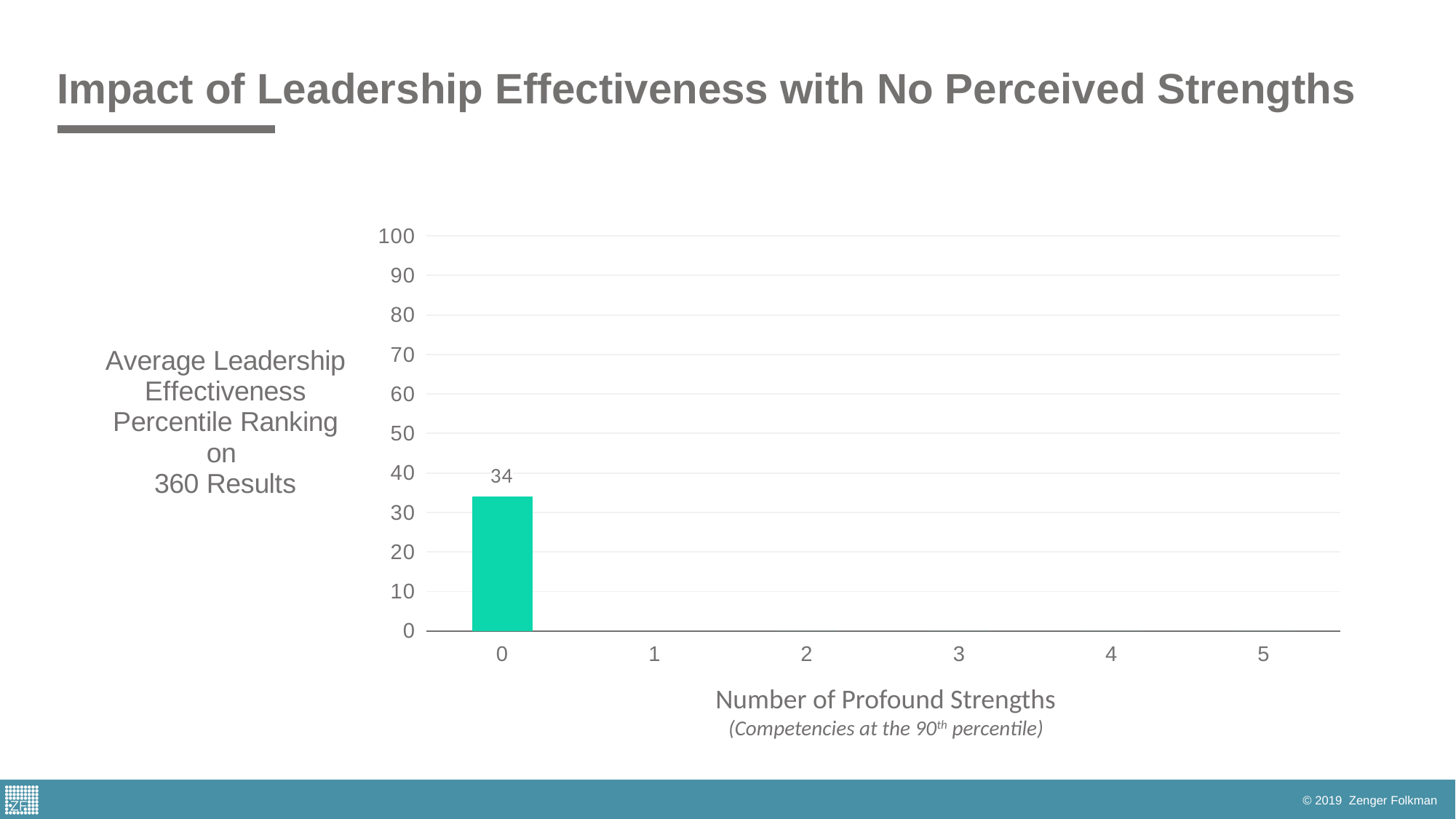
What kind of chart is shown on the slide? bar chart How many bars are actually plotted in the chart? 1 Which category on the x axis has a bar plotted? 0 What is the label of the x axis? Number of Profound Strengths Is the value for 0 profound strengths greater or less than 40? less Is the value for 0 profound strengths greater or less than 30? greater How many categories are shown along the x axis of the chart? 6 What is the title of the chart on the slide? Impact of Leadership Effectiveness with No Perceived Strengths What is the highest value shown on the y axis? 100 What is the value of the bar for 0 profound strengths? 34 What is the highest category label on the x axis? 5 What is the lowest category label on the x axis? 0